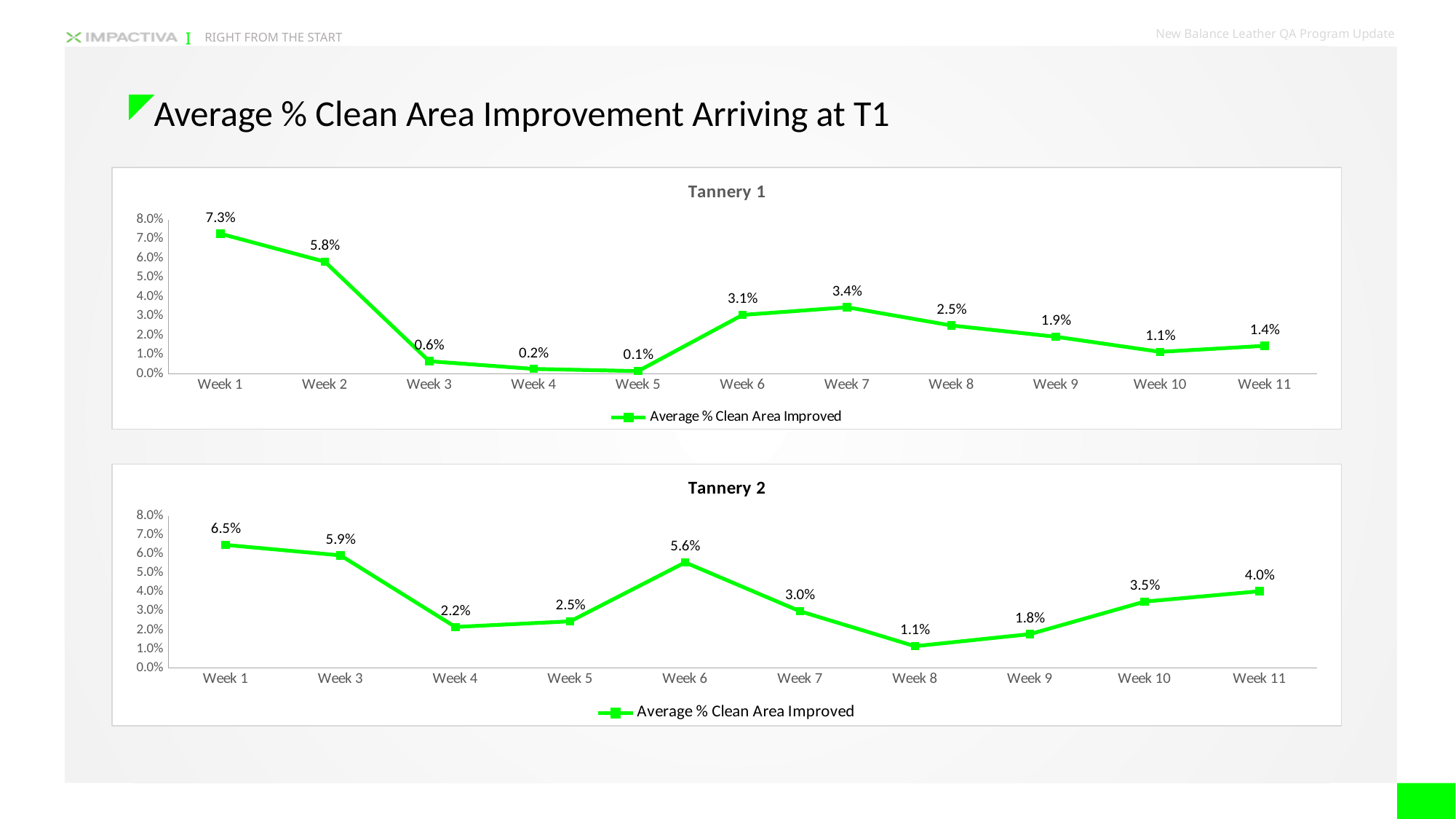
In the Tannery 1 chart, which week has the lowest value? Week 5 In the Tannery 2 chart, which week has the lowest value? Week 8 In the Tannery 2 chart, which is larger, the value for Week 10 or the value for Week 11? Week 11 In the Tannery 1 chart, what is the difference between the Week 1 and Week 2 values? 1.5% In the Tannery 2 chart, how many weeks are plotted on the x axis? 10 How many series does the legend of the Tannery 2 chart list? 1 In the Tannery 2 chart, what is the value for Week 6? 5.6% In the Tannery 2 chart, which week has the highest value? Week 1 In the Tannery 1 chart, how many weeks are plotted on the x axis? 11 In the Tannery 1 chart, do the values rise or fall from Week 1 to Week 5? Fall In the Tannery 1 chart, what is the Average % Clean Area Improved value for Week 1? 7.3% What type of chart is the Tannery 1 chart? Line chart